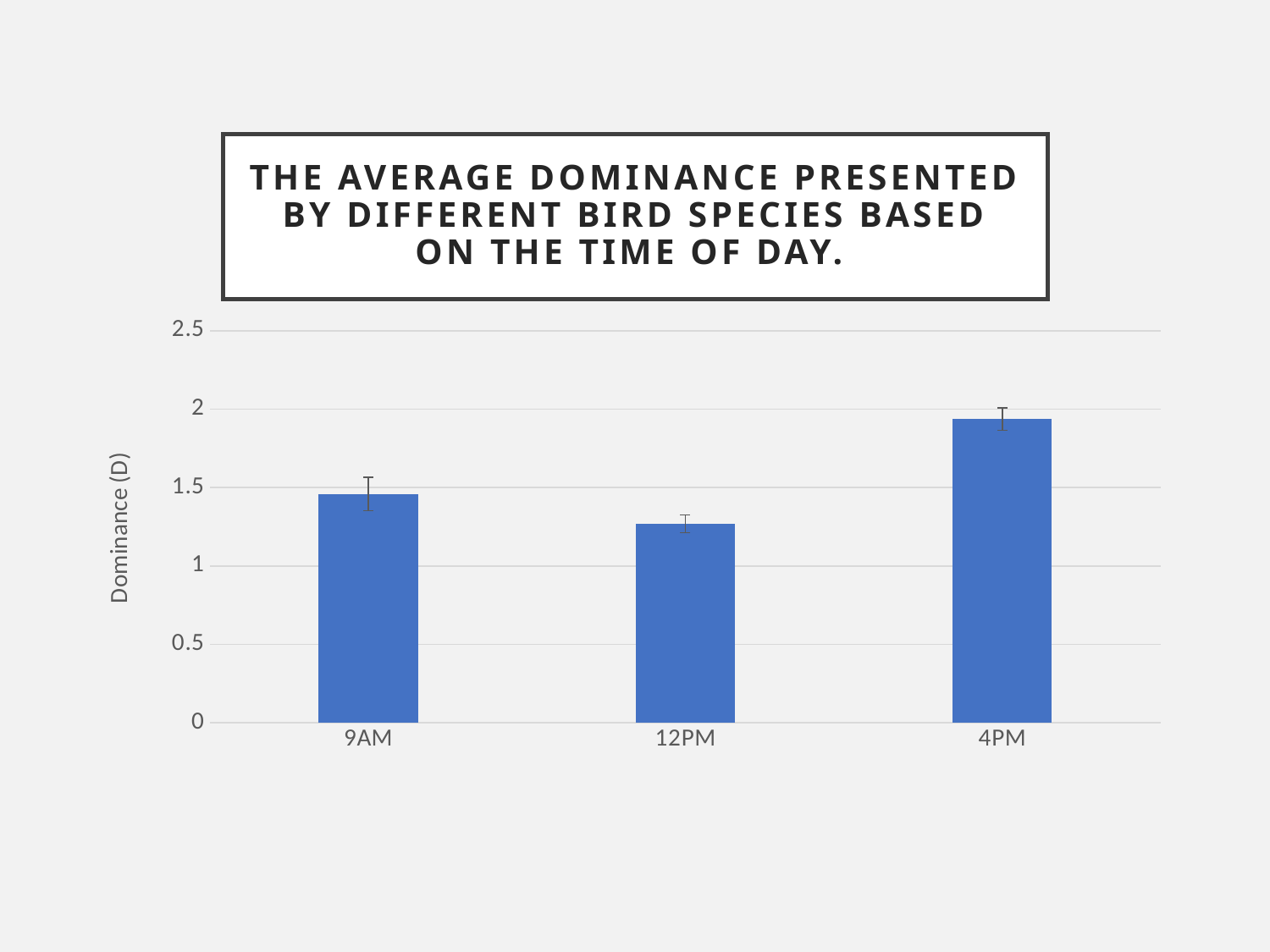
Is the value for 4PM greater or less than 1.5? greater Is the value for 12PM greater or less than 1.5? less Which is larger, the value for 12PM or the value for 4PM? 4PM What is the highest value shown on the vertical axis? 2.5 What kind of chart is shown on the slide? bar chart Which time of day has the highest average dominance? 4PM Is the value for 9AM greater or less than 1? greater Which time of day has the lowest average dominance? 12PM What is the label of the vertical axis? Dominance (D) Which is larger, the value for 9AM or the value for 12PM? 9AM How many time-of-day categories are plotted on the chart? 3